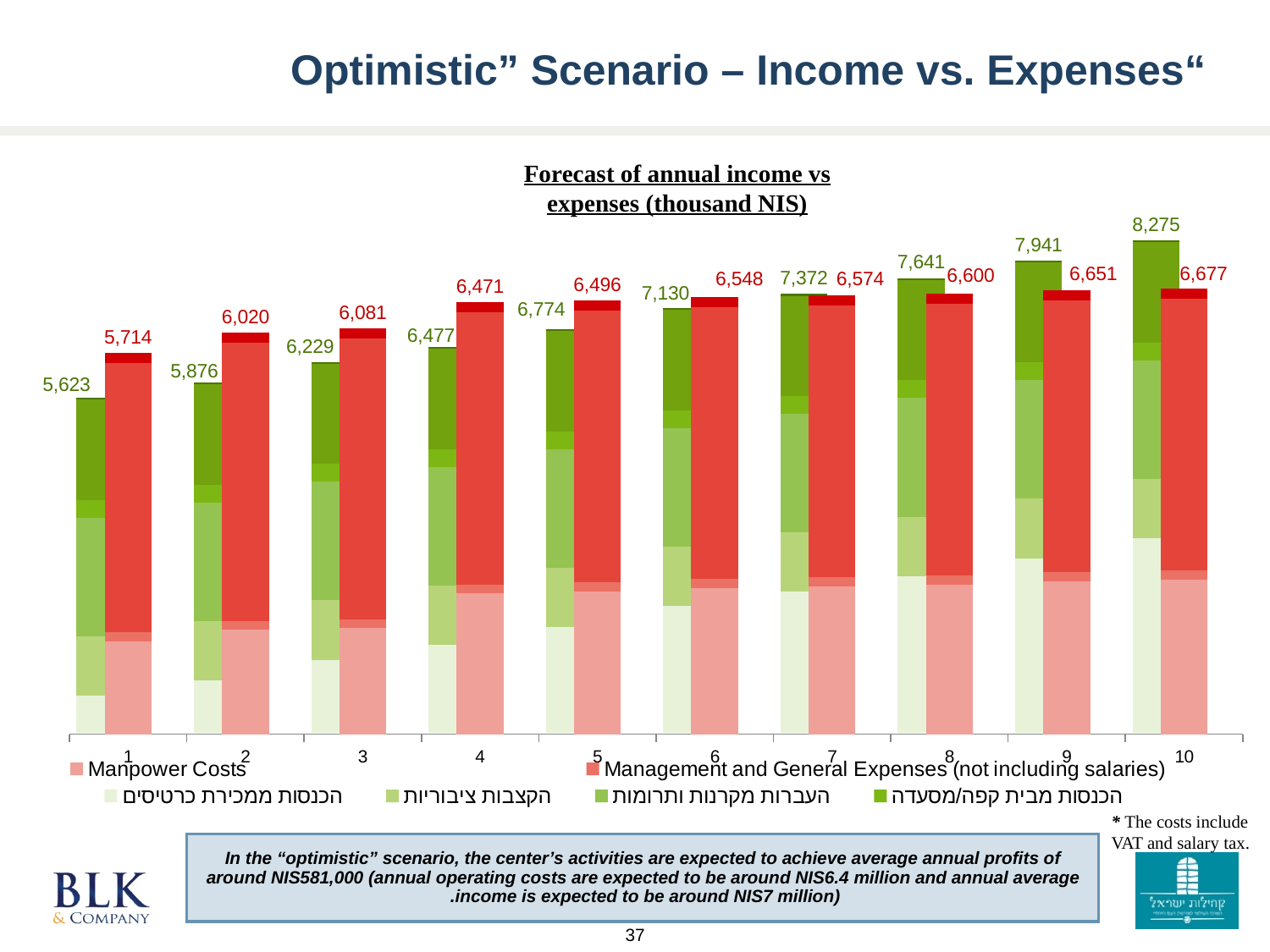
In which year is total income the highest? 10 What is the total income (green stacked bar) for year 1? 5,623 What is the difference between total income and total expenses in year 10? 1,598 How many years are shown on the x axis? 10 What kind of chart is shown? Stacked bar chart In year 7, which is larger: total income or total expenses? Total income How many series does the legend list? 6 In which year is total expenses the lowest? 1 Do total income values rise or fall from year 1 to year 10? Rise In year 2, which is larger: total income or total expenses? Total expenses What is the total expenses (red stacked bar) for year 10? 6,677 What is the total income for year 6? 7,130